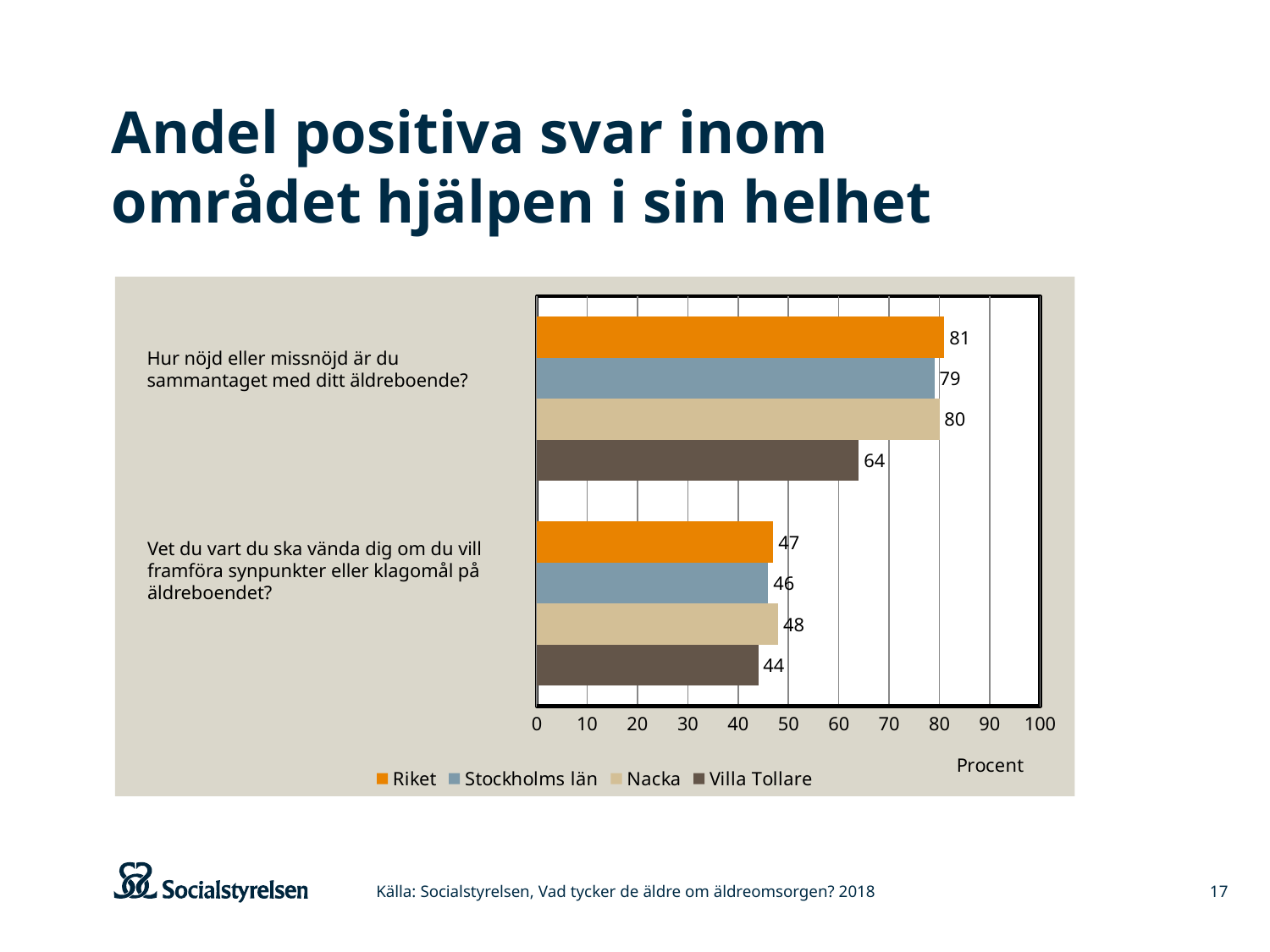
What kind of chart is shown on the slide? bar chart Which series has the lowest value on the question "Hur nöjd eller missnöjd är du sammantaget med ditt äldreboende?"? Villa Tollare What is the value for Riket on the question "Hur nöjd eller missnöjd är du sammantaget med ditt äldreboende?"? 81 How many series does the legend list? 4 Is the value for Riket on the question "Vet du vart du ska vända dig om du vill framföra synpunkter eller klagomål på äldreboendet?" greater or less than 50? less What is the value for Nacka on the question "Vet du vart du ska vända dig om du vill framföra synpunkter eller klagomål på äldreboendet?"? 48 What unit is shown on the x axis of the chart? Procent What is the value for Stockholms län on the question "Vet du vart du ska vända dig om du vill framföra synpunkter eller klagomål på äldreboendet?"? 46 What is the difference between Riket and Villa Tollare on the question "Hur nöjd eller missnöjd är du sammantaget med ditt äldreboende?"? 17 What is the value for Villa Tollare on the question "Hur nöjd eller missnöjd är du sammantaget med ditt äldreboende?"? 64 Which series has the highest value on the question "Vet du vart du ska vända dig om du vill framföra synpunkter eller klagomål på äldreboendet?"? Nacka Which is larger for Villa Tollare: the value for "Hur nöjd eller missnöjd är du sammantaget med ditt äldreboende?" or for "Vet du vart du ska vända dig om du vill framföra synpunkter eller klagomål på äldreboendet?"? Hur nöjd eller missnöjd är du sammantaget med ditt äldreboende?